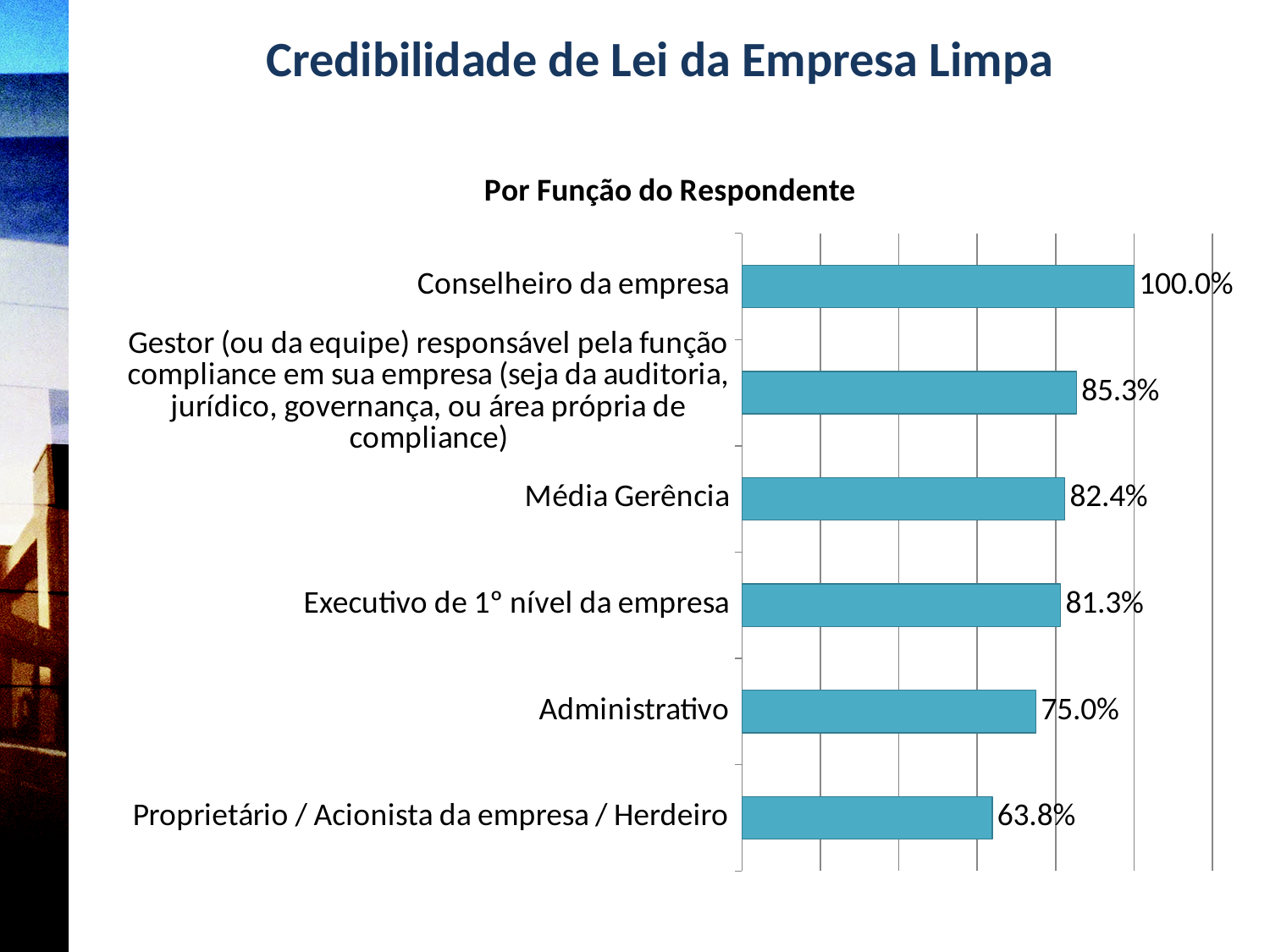
What is the difference between the values for Conselheiro da empresa and Administrativo? 25.0% What kind of chart is shown on the slide? Bar chart What is the value for Conselheiro da empresa? 100.0% What is the value for Executivo de 1º nível da empresa? 81.3% What is the title of the chart? Por Função do Respondente Which category has the highest value? Conselheiro da empresa How many categories are shown in the chart? 6 What is the value for Administrativo? 75.0% What is the value for Proprietário / Acionista da empresa / Herdeiro? 63.8% Which category has the lowest value? Proprietário / Acionista da empresa / Herdeiro Which is larger, the value for Média Gerência or the value for Administrativo? Média Gerência What is the value for Média Gerência? 82.4%